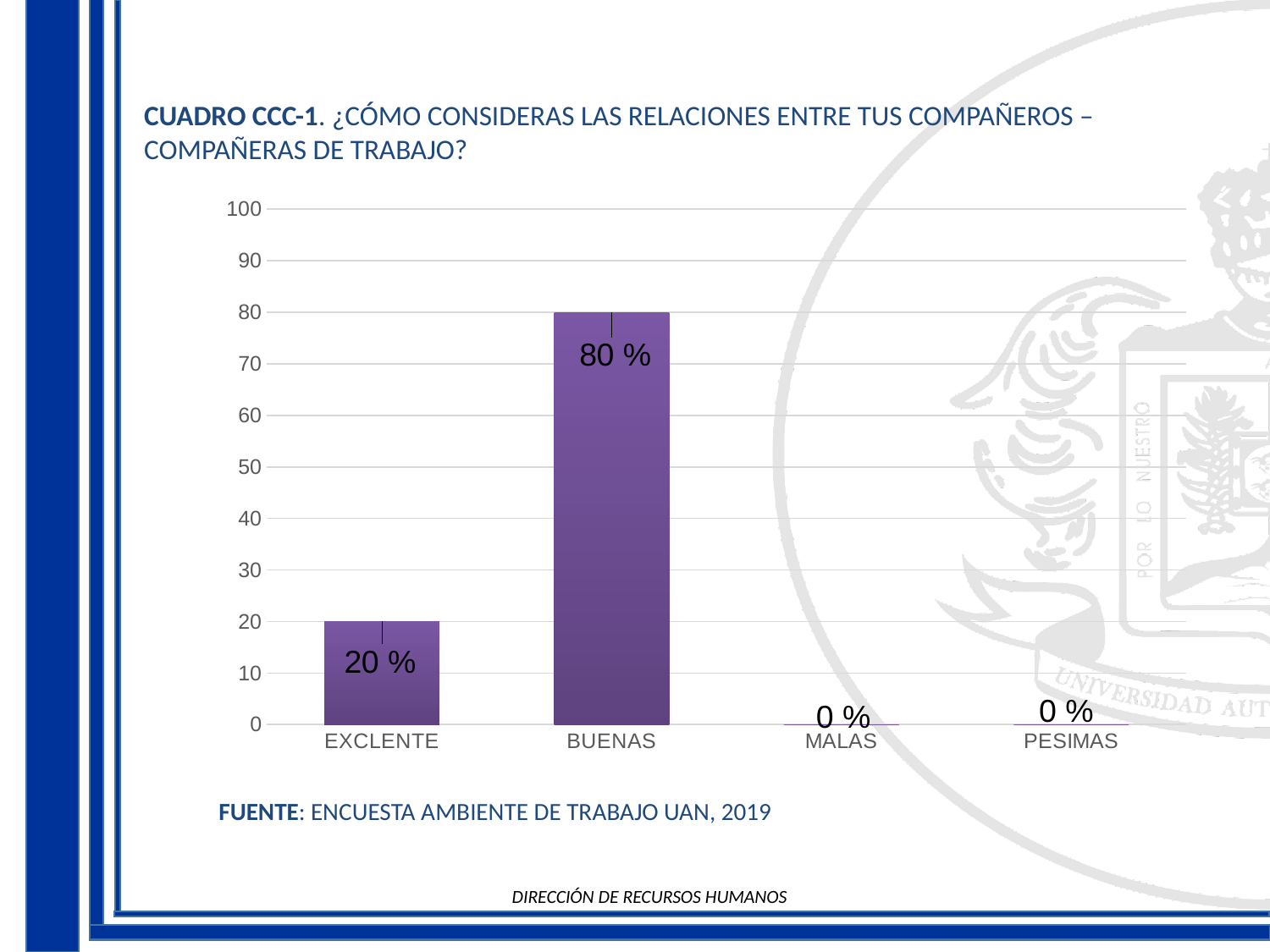
Which is larger, the value for EXCLENTE or the value for BUENAS? BUENAS What is the value for MALAS? 0 % What is the maximum value shown on the y axis? 100 What source is cited below the chart? ENCUESTA AMBIENTE DE TRABAJO UAN, 2019 What is the difference between the values for BUENAS and EXCLENTE? 60 % What is the value for PESIMAS? 0 % Is the value for BUENAS greater or less than 50? greater How many categories are shown on the x axis? 4 What is the value for EXCLENTE? 20 % Which category has the highest value? BUENAS What is the value for BUENAS? 80 % What kind of chart is shown on the slide? bar chart